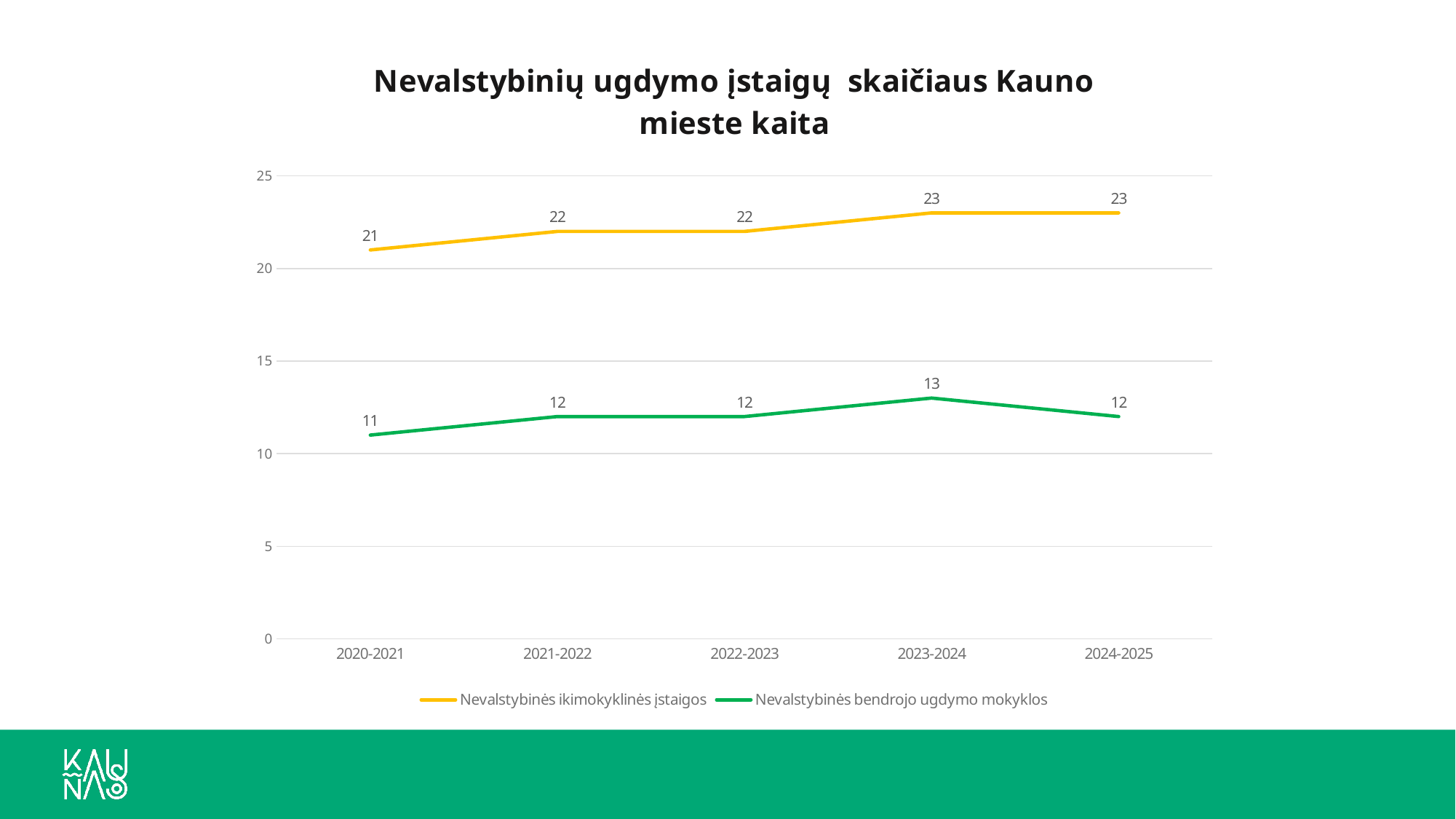
How many periods are shown on the x axis? 5 What is the difference between Nevalstybinės ikimokyklinės įstaigos and Nevalstybinės bendrojo ugdymo mokyklos in 2022-2023? 10 What is the value for Nevalstybinės ikimokyklinės įstaigos in 2024-2025? 23 In which period is the value for Nevalstybinės bendrojo ugdymo mokyklos lowest? 2020-2021 How many series does the legend list? 2 Does the value for Nevalstybinės ikimokyklinės įstaigos rise or fall from 2020-2021 to 2024-2025? rise Which series has the larger value in 2021-2022, Nevalstybinės ikimokyklinės įstaigos or Nevalstybinės bendrojo ugdymo mokyklos? Nevalstybinės ikimokyklinės įstaigos What is the value for Nevalstybinės ikimokyklinės įstaigos in 2020-2021? 21 In which period is the value for Nevalstybinės bendrojo ugdymo mokyklos highest? 2023-2024 Is the value for Nevalstybinės ikimokyklinės įstaigos in 2023-2024 greater or less than 20? greater What kind of chart is shown on the slide? line chart What is the value for Nevalstybinės bendrojo ugdymo mokyklos in 2023-2024? 13